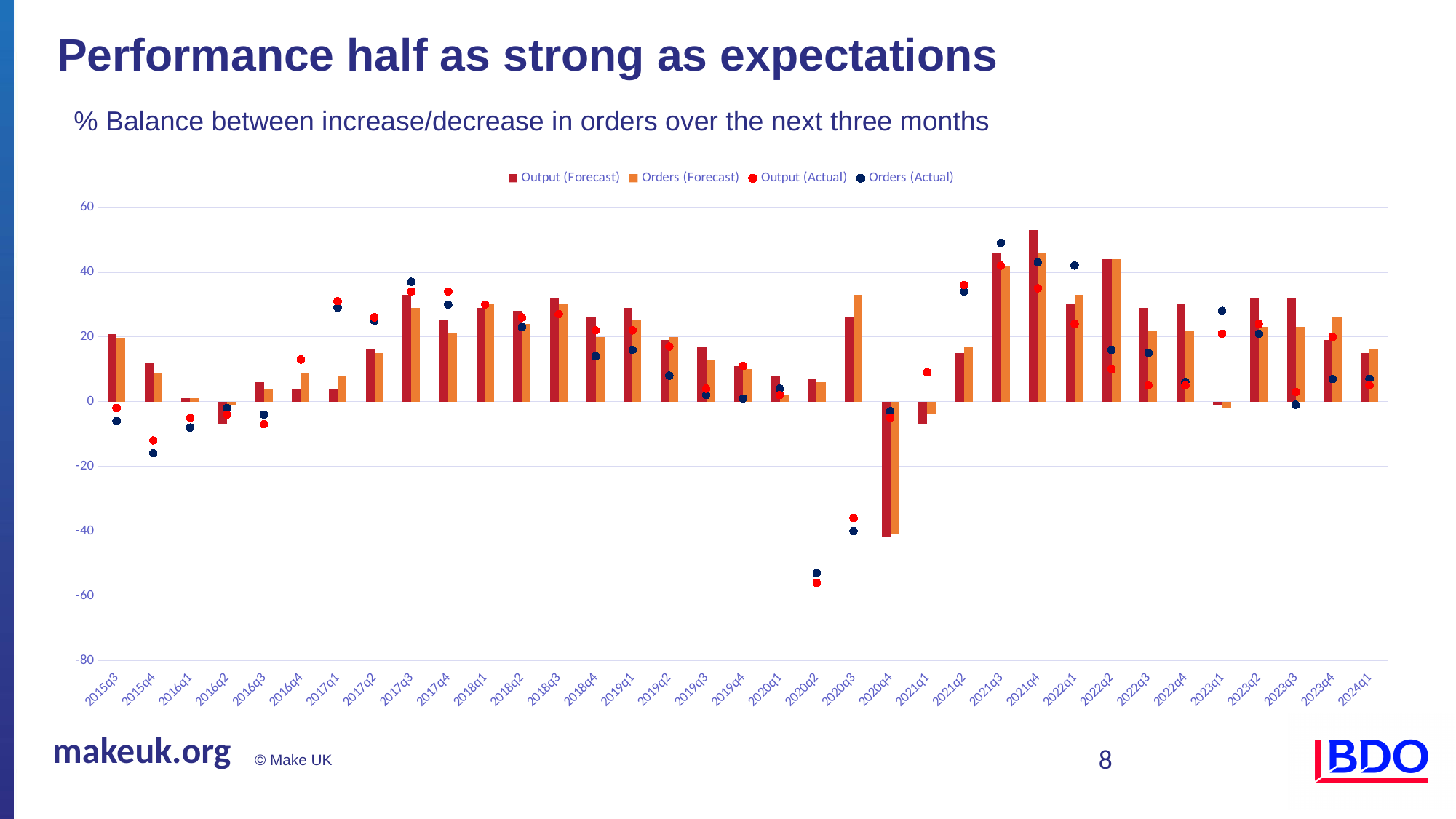
Which quarter has the lowest Output (Actual) point? 2020q2 Is the Orders (Forecast) value for 2020q3 greater or less than 20? greater Is the Output (Actual) value for 2020q2 greater or less than -40? less Which quarter has the lowest Output (Forecast) bar? 2020q4 What kind of chart is shown on the slide? Bar chart with overlaid points (combination chart) Which is larger, the Orders (Actual) value for 2020q2 or for 2020q4? 2020q4 How many series does the legend list? 4 Is the Output (Forecast) value for 2021q4 greater or less than 40? greater Which is larger, the Output (Forecast) value for 2021q4 or for 2022q1? 2021q4 How many quarters are shown on the x axis? 35 What is the subtitle describing the chart's measure? % Balance between increase/decrease in orders over the next three months Which quarter has the highest Output (Forecast) bar? 2021q4